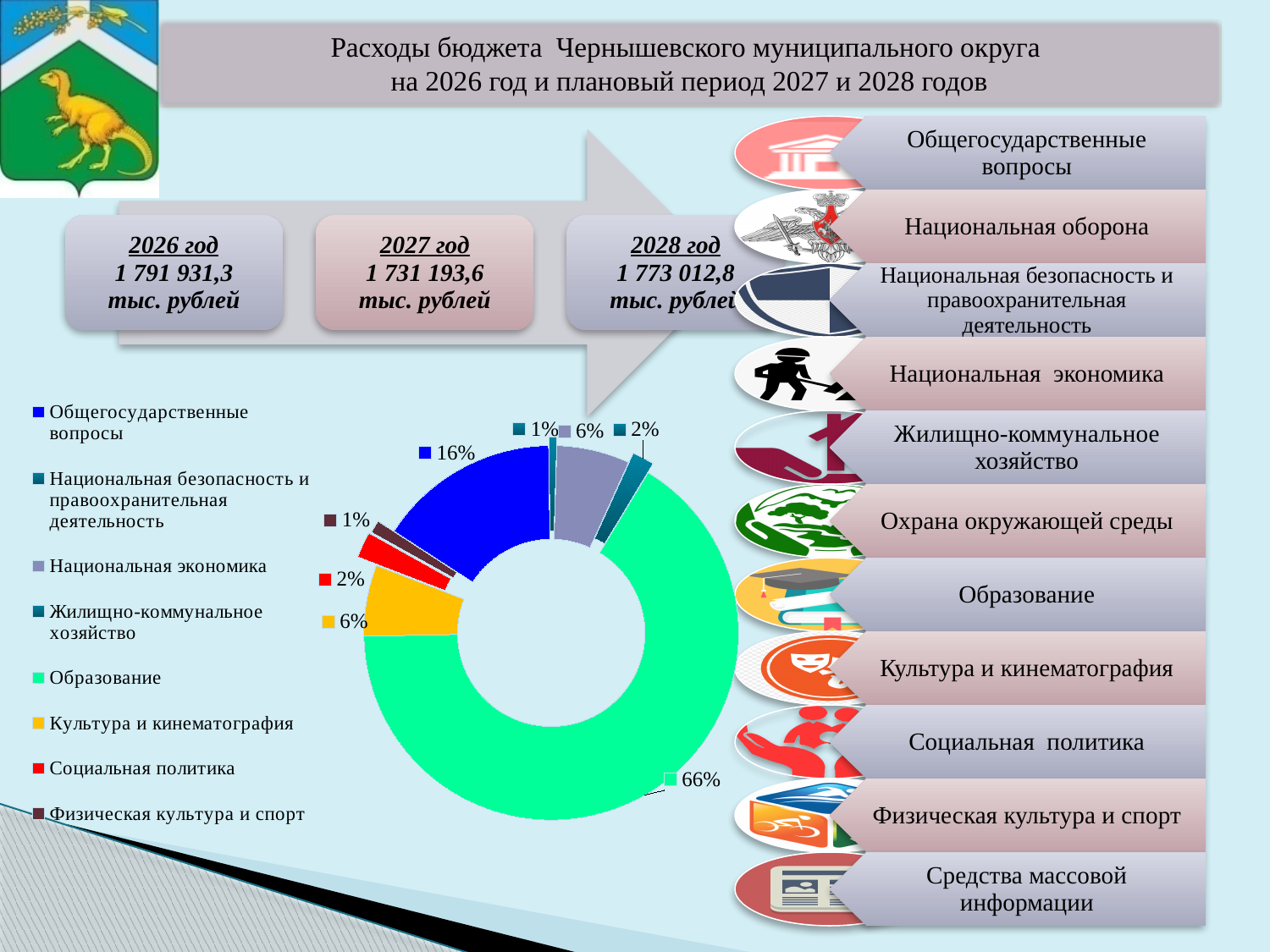
What percentage is shown for Социальная политика in the doughnut chart? 2% What type of chart is shown on the slide? Doughnut (pie) chart What share of the doughnut chart does Образование account for? 66% How many categories does the legend of the doughnut chart list? 8 Which is larger in the doughnut chart: Общегосударственные вопросы or Национальная экономика? Общегосударственные вопросы What colour represents Образование in the doughnut chart? Green What percentage is shown for Культура и кинематография in the doughnut chart? 6% Which category has the largest share in the doughnut chart? Образование What is the combined share of Культура и кинематография and Социальная политика in the doughnut chart? 8% What is the difference in percentage points between Образование and Общегосударственные вопросы in the doughnut chart? 50 What percentage is shown for Жилищно-коммунальное хозяйство in the doughnut chart? 2% What percentage is shown for Общегосударственные вопросы in the doughnut chart? 16%